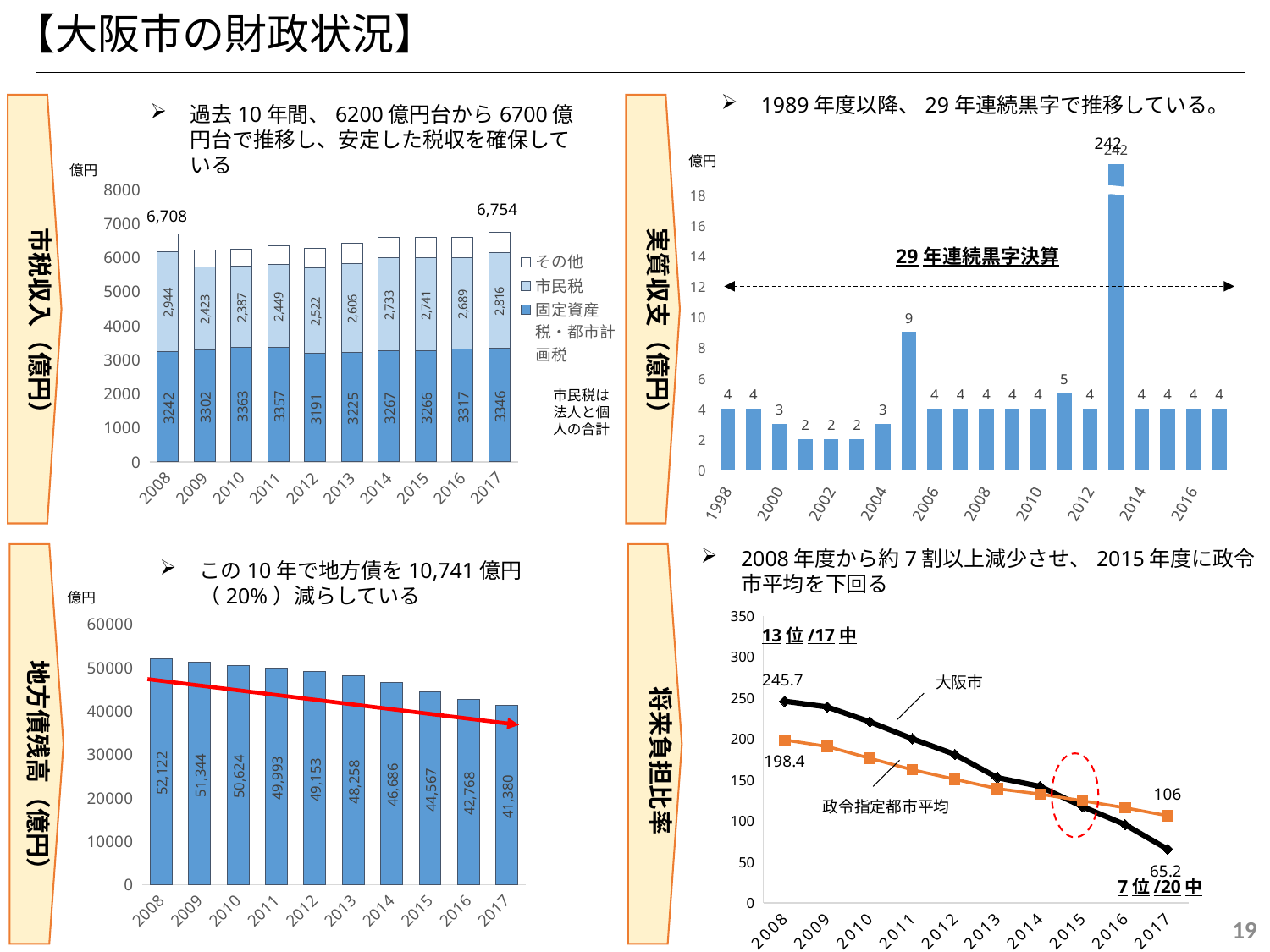
In the 市税収入 chart (top left), what is the value of 固定資産税・都市計画税 for 2008? 3242 In the 市税収入 chart (top left), how many series does the legend list? 3 In the 市税収入 chart (top left), what is the 市民税 value for 2017? 2,816 In the 将来負担比率 chart (bottom right), which is larger in 2008: 大阪市 or 政令指定都市平均? 大阪市 In the 実質収支 chart (top right), how many years are plotted? 20 In the 将来負担比率 chart (bottom right), what is the 大阪市 value for 2017? 65.2 In the 地方債残高 chart (bottom left), what is the difference between the 2016 value and the 2017 value? 1,388 In the 実質収支 chart (top right), what is the value for 2005? 9 In the 地方債残高 chart (bottom left), what is the value for 2017? 41,380 In the 実質収支 chart (top right), which year has the highest value? 2013 In the 市税収入 chart (top left), what is the difference between the 2017 total (6,754) and the 2008 total (6,708)? 46 In the 地方債残高 chart (bottom left), do the values rise or fall from 2008 to 2017? fall